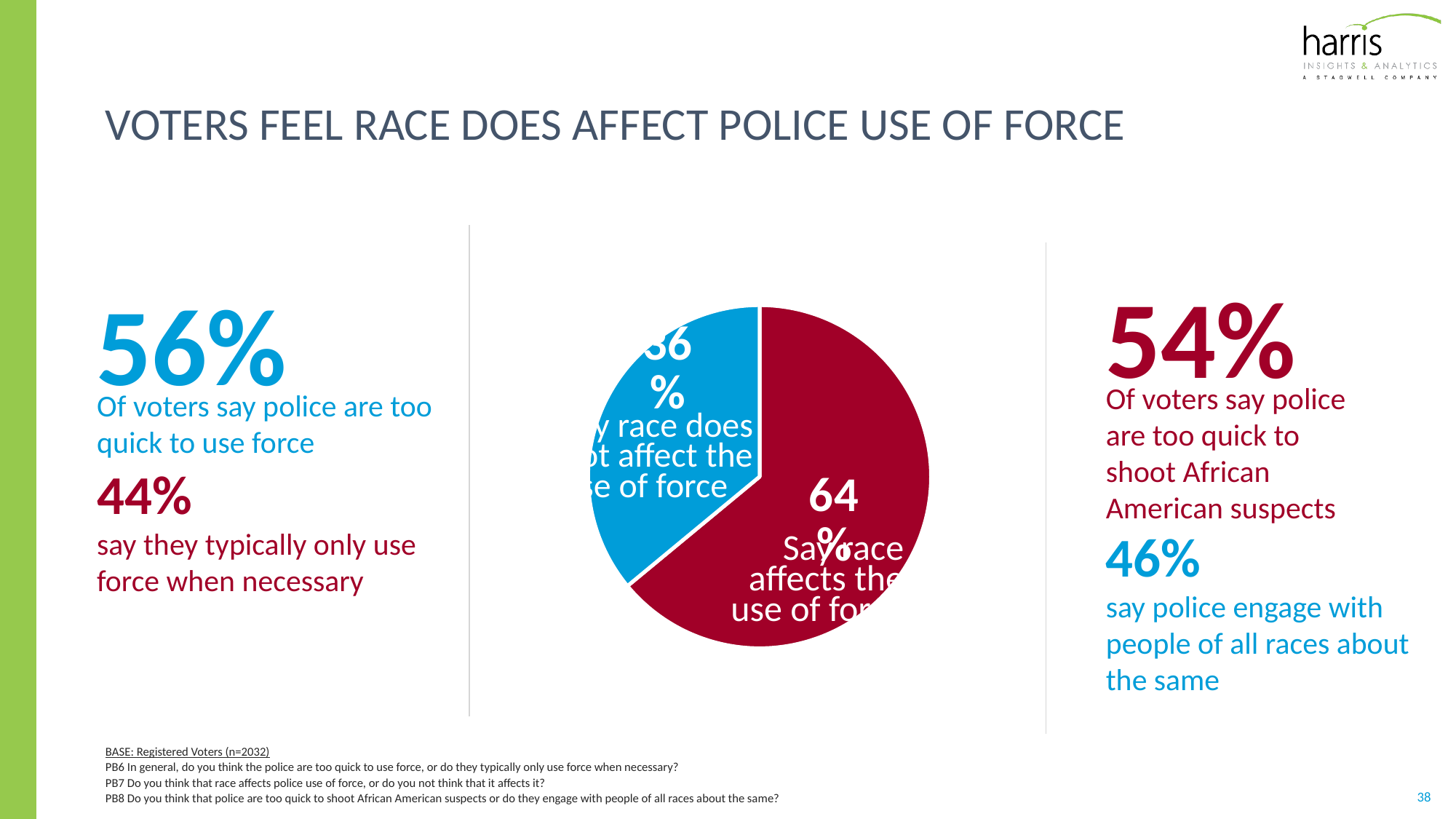
In the pie chart, what is the difference in percentage points between the share saying race affects the use of force and the share saying it does not? 28 percentage points In the pie chart, what percentage of voters say race does not affect the use of force? 36% What do the two slices of the pie chart add up to? 100% Is the pie chart slice for voters who say race affects the use of force more or less than half of the pie? More How many slices does the pie chart have? 2 What colour is the pie chart slice for voters who say race affects the use of force? Red In the pie chart, which is larger: the share saying race affects the use of force or the share saying it does not? Say race affects the use of force What kind of chart is shown in the centre of the slide? Pie chart What colour is the pie chart slice for voters who say race does not affect the use of force? Blue In the pie chart, what percentage of voters say race affects the use of force? 64% Which slice of the pie chart is the smallest? Say race does not affect the use of force Which slice of the pie chart is the largest? Say race affects the use of force